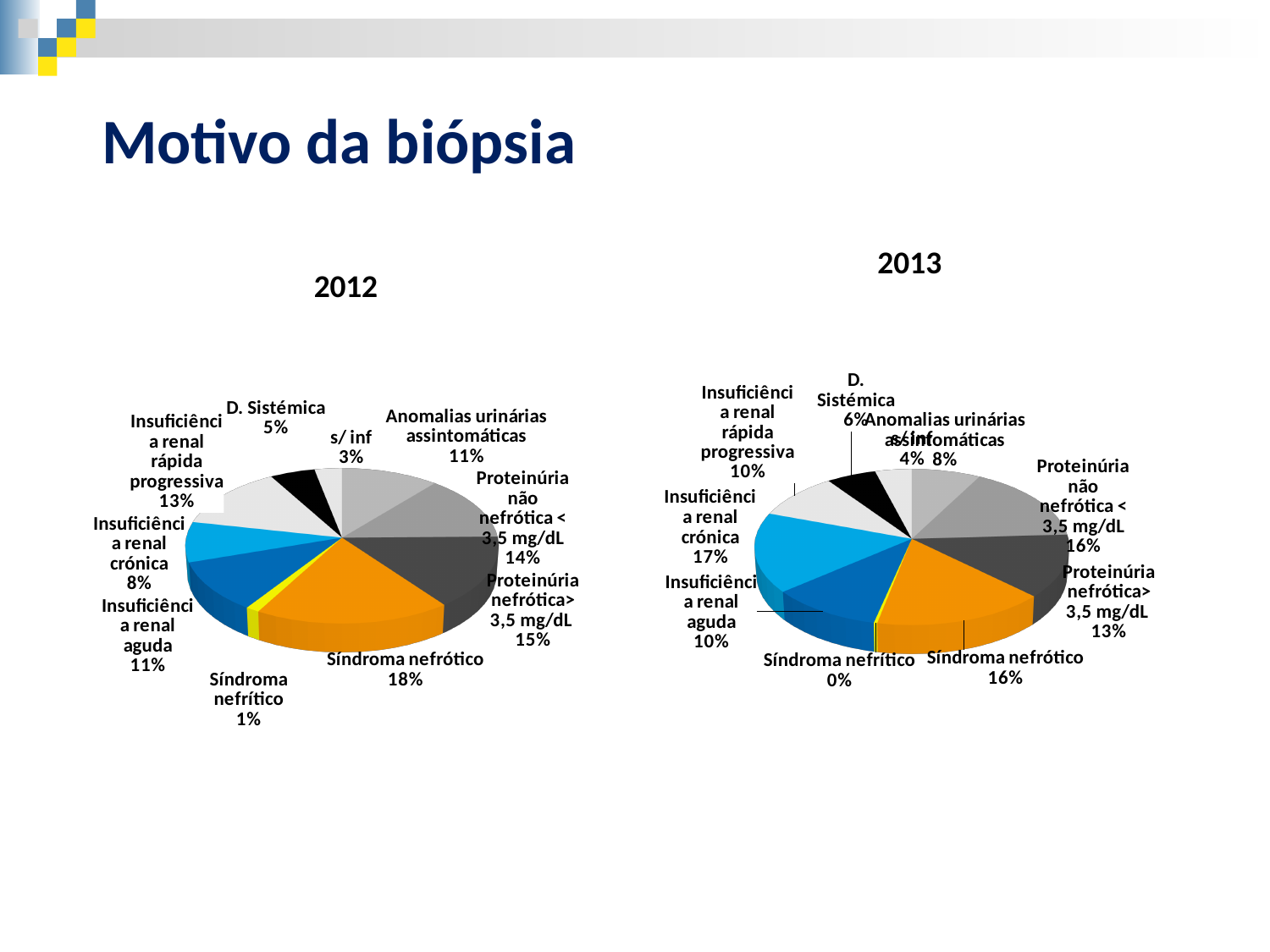
In the 2012 chart, what is the difference in percentage points between Proteinúria nefrótica > 3,5 mg/dL and Insuficiência renal crónica? 7 What type of chart is used for the 2013 data? Pie chart In the 2012 chart, what share of biopsies was for Síndroma nefrótico? 18% In the 2012 chart, what percentage is shown for Proteinúria não nefrótica < 3,5 mg/dL? 14% In the 2013 chart, what percentage is shown for D. Sistémica? 6% In the 2013 chart, which category has the smallest share? Síndroma nefrítico How many categories does the 2012 pie chart show? 10 In the 2013 chart, what share of biopsies was for Insuficiência renal crónica? 17% In the 2012 chart, which category has the smallest share? Síndroma nefrítico In the 2013 chart, which is larger: Proteinúria não nefrótica < 3,5 mg/dL or Anomalias urinárias assintomáticas? Proteinúria não nefrótica < 3,5 mg/dL In the 2012 chart, which category has the largest share? Síndroma nefrótico In the 2013 chart, which category has the largest share? Insuficiência renal crónica